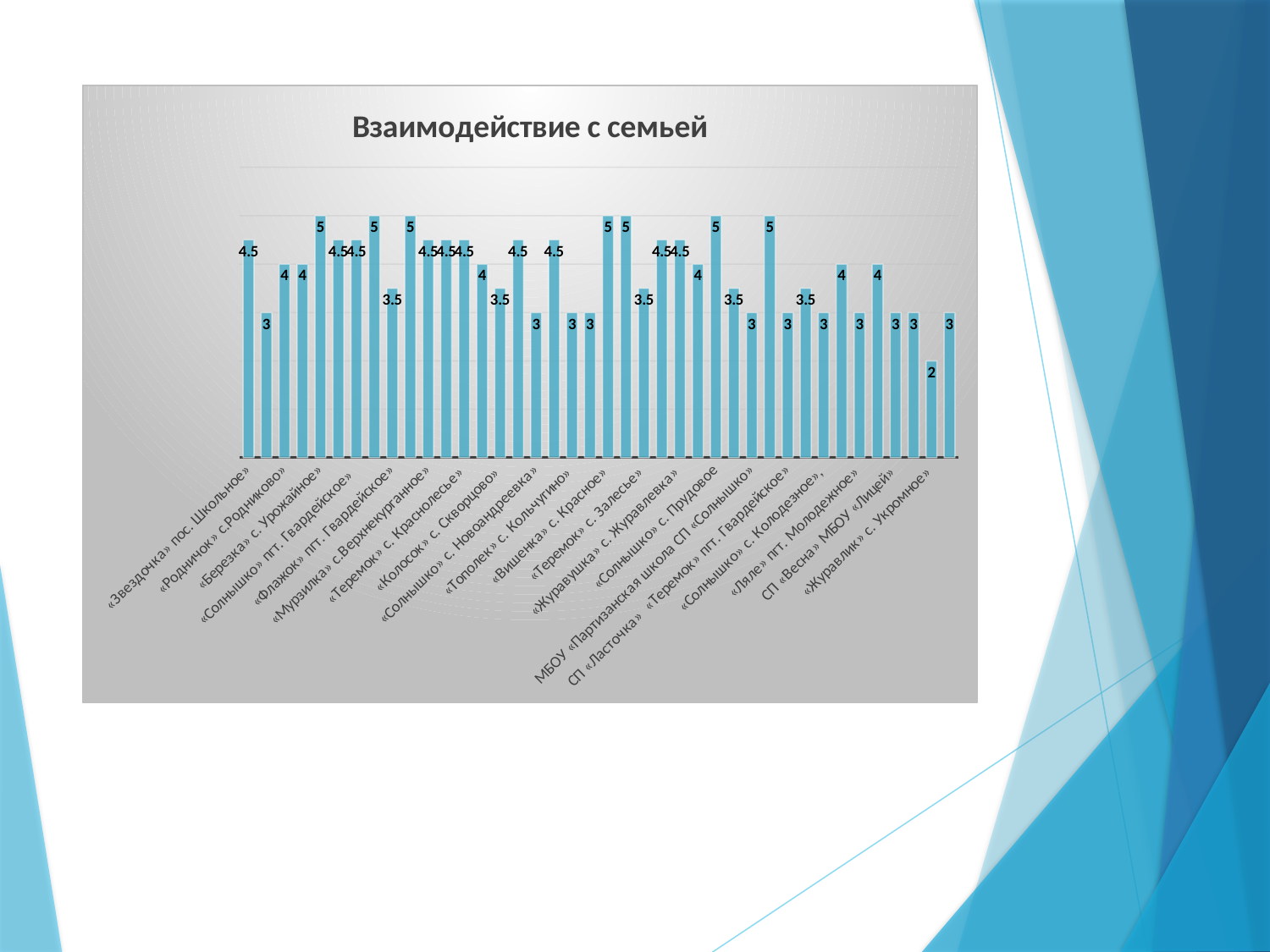
What is the lowest value shown by any bar in the chart? 2 Which is larger, the leftmost bar or the rightmost bar? the leftmost bar How many bars are plotted in the chart? 40 What is the highest value shown by any bar in the chart? 5 What is the value of the rightmost bar in the chart? 3 What is the title of the chart? Взаимодействие с семьей What is the value of the second bar from the left in the chart? 3 What is the difference between the leftmost bar (4.5) and the rightmost bar (3)? 1.5 How many bars in the chart have a value of 5? 7 What kind of chart is shown on the slide? bar chart What is the value of the leftmost bar in the chart? 4.5 What is the value of the second bar from the right in the chart? 2